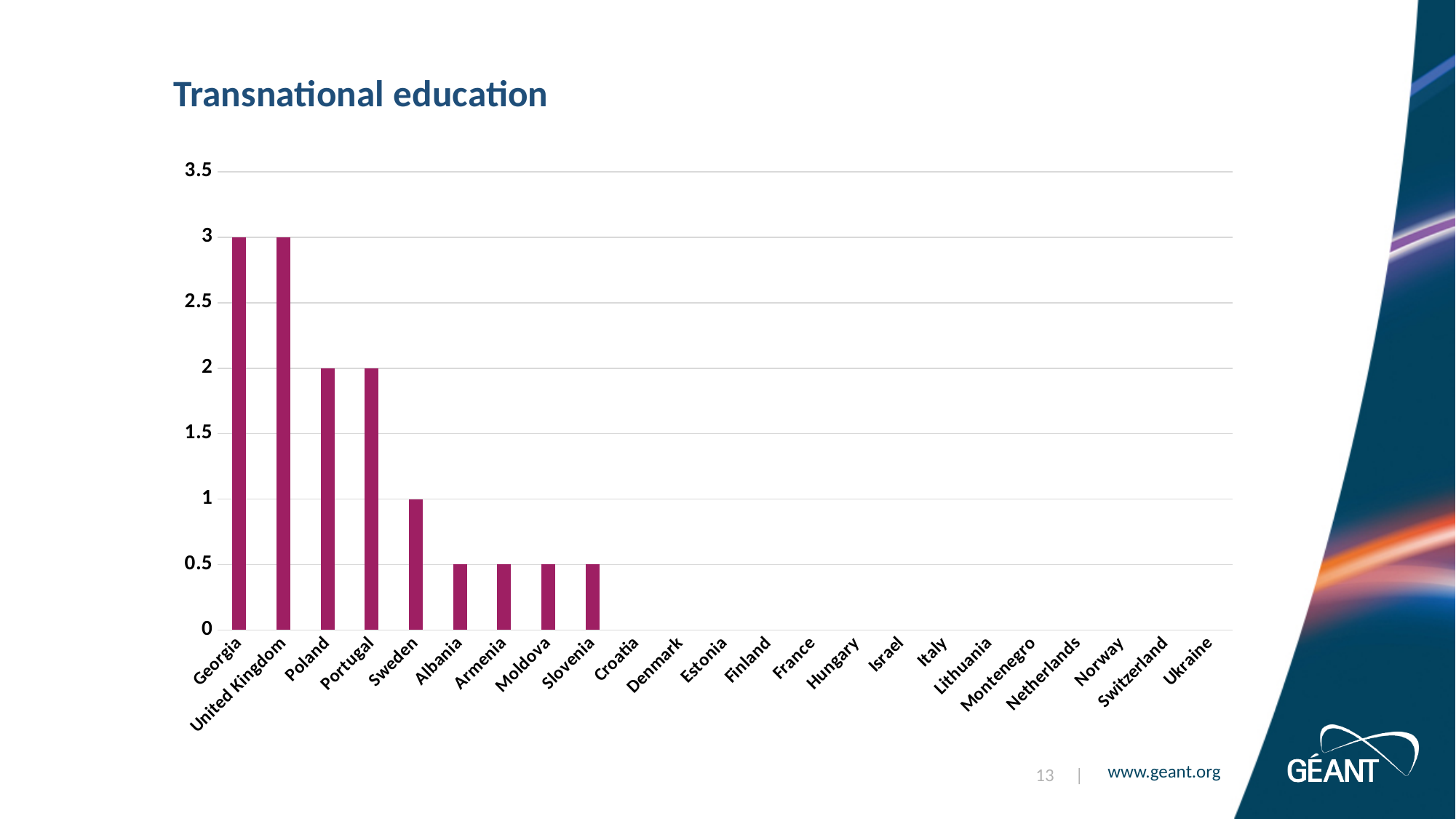
Is the value for United Kingdom greater or less than 2.5? greater What kind of chart is shown on the slide? bar chart How many countries are listed on the x axis? 23 What is the value for Sweden? 1 What is the value for Georgia? 3 What is the difference between the values for Georgia and Poland? 1 What is the difference between the values for Sweden and Albania? 0.5 What is the title of the chart? Transnational education Which has a larger value, Portugal or Sweden? Portugal What is the value for Poland? 2 What is the value for Moldova? 0.5 Do the values rise or fall from left to right along the x axis? fall